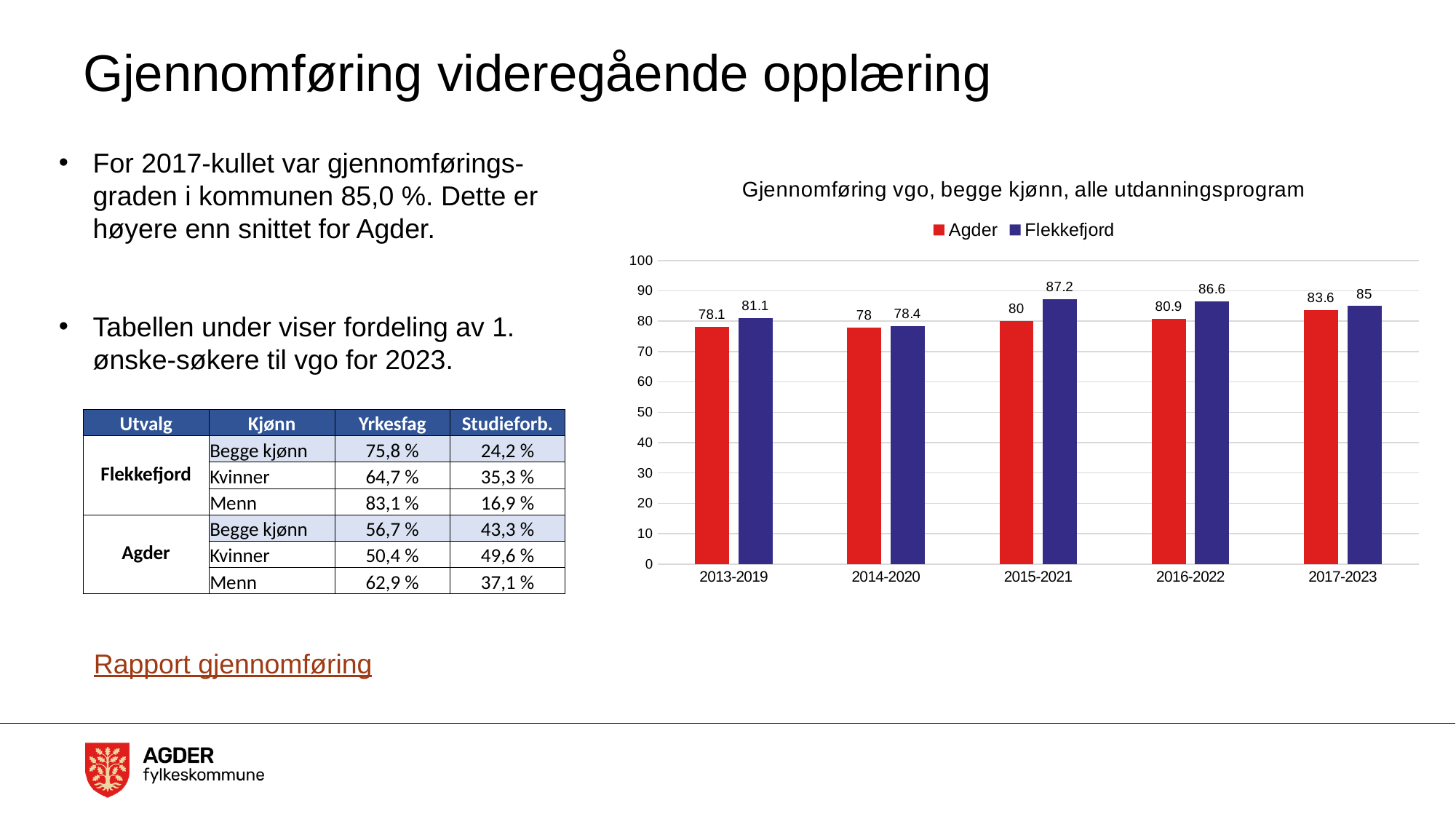
Which is larger in 2013-2019, Agder or Flekkefjord? Flekkefjord What kind of chart is shown? bar chart Which period has the lowest value for Agder? 2014-2020 Is the value for Flekkefjord in 2016-2022 greater or less than 80? greater What is the difference between Flekkefjord and Agder in 2015-2021? 7.2 What is the title of the chart? Gjennomføring vgo, begge kjønn, alle utdanningsprogram How many series does the legend list? 2 How many periods are shown on the x axis? 5 What is the value for Flekkefjord in 2015-2021? 87.2 Which period has the highest value for Flekkefjord? 2015-2021 What is the value for Agder in 2014-2020? 78 What is the value for Agder in 2017-2023? 83.6